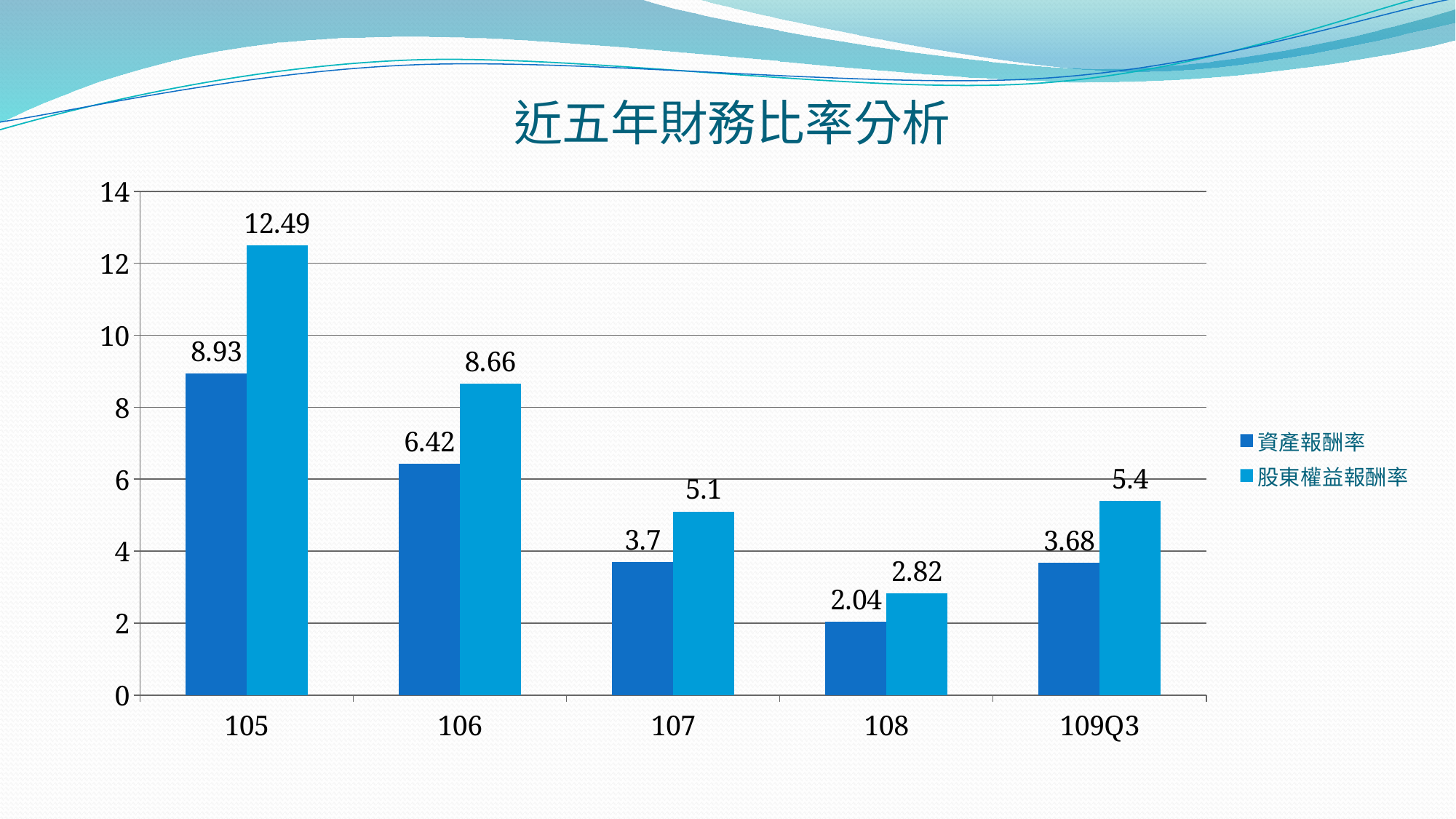
Which is larger, 資產報酬率 for 107 or 資產報酬率 for 109Q3? 107 How many series does the legend list? 2 Does 股東權益報酬率 rise or fall from 105 to 108? Fall Which category has the lowest 資產報酬率? 108 Which category has the highest 股東權益報酬率? 105 What kind of chart is shown on the slide? Bar chart What is the difference between 股東權益報酬率 and 資產報酬率 for 106? 2.24 What is the value of 股東權益報酬率 for 107? 5.1 What is the title of the chart? 近五年財務比率分析 What is the value of 資產報酬率 for 105? 8.93 What is the value of 股東權益報酬率 for 109Q3? 5.4 How many categories are shown on the x axis? 5